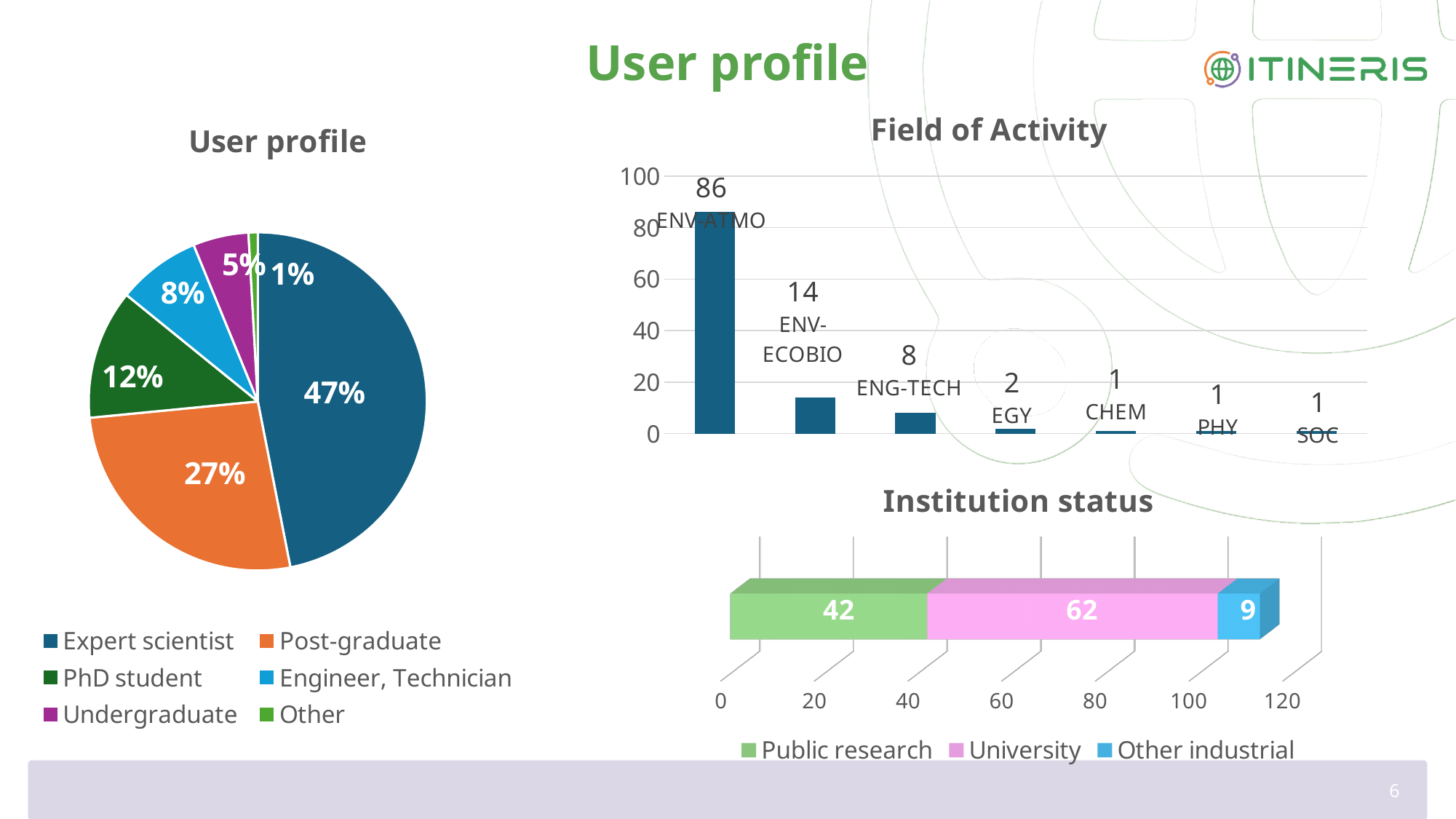
In the User profile pie chart, what is the difference between the Post-graduate and PhD student shares? 15% In the Institution status chart, which is larger, Public research or Other industrial? Public research In the User profile pie chart, which category has the smallest share? Other In the Field of Activity chart, which category has the highest value? ENV-ATMO In the User profile pie chart, what share is Expert scientist? 47% In the Institution status chart, what is the value for University? 62 In the Field of Activity chart, what kind of chart is it? Bar chart In the User profile pie chart, how many categories does the legend list? 6 In the Field of Activity chart, what is the difference between ENV-ATMO and ENG-TECH? 78 In the Field of Activity chart, how many categories are shown? 7 In the Institution status chart, what is the total of the stacked bar? 113 In the Field of Activity chart, what is the value for ENV-ECOBIO? 14